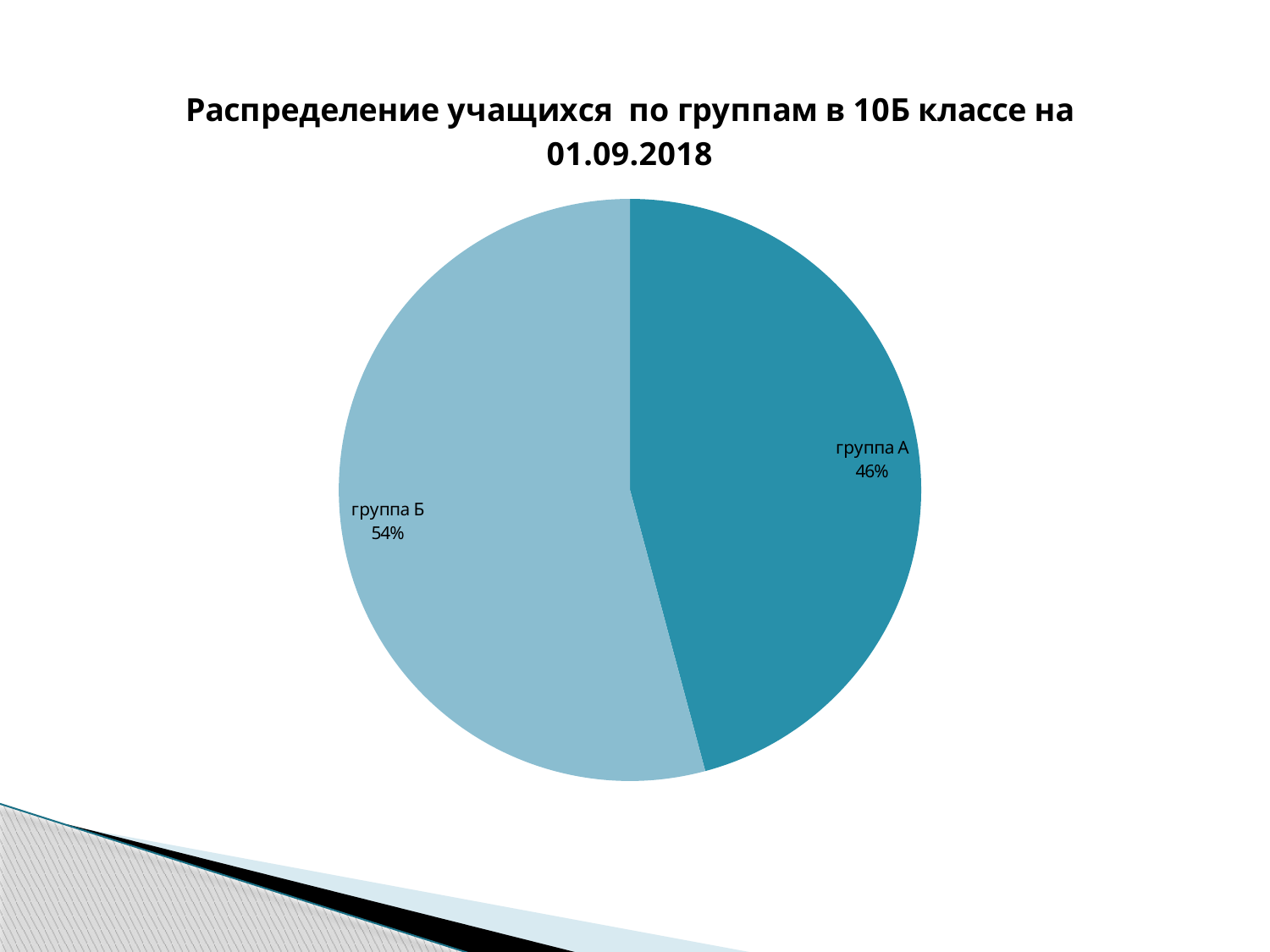
What is the title of the chart? Распределение учащихся по группам в 10Б классе на 01.09.2018 What is the difference in percentage points between группа Б and группа А? 8 How many slices does the pie chart have? 2 Is the share for группа А greater or less than 50%? less Which is larger, the share for группа А or the share for группа Б? группа Б What share of the pie does группа Б represent? 54% Which slice is shown in the darker blue colour? группа А What share of the pie does группа А represent? 46% Is the share for группа Б greater or less than 50%? greater Which group has the smallest share of the pie? группа А Which group has the largest share of the pie? группа Б What kind of chart is shown on the slide? pie chart